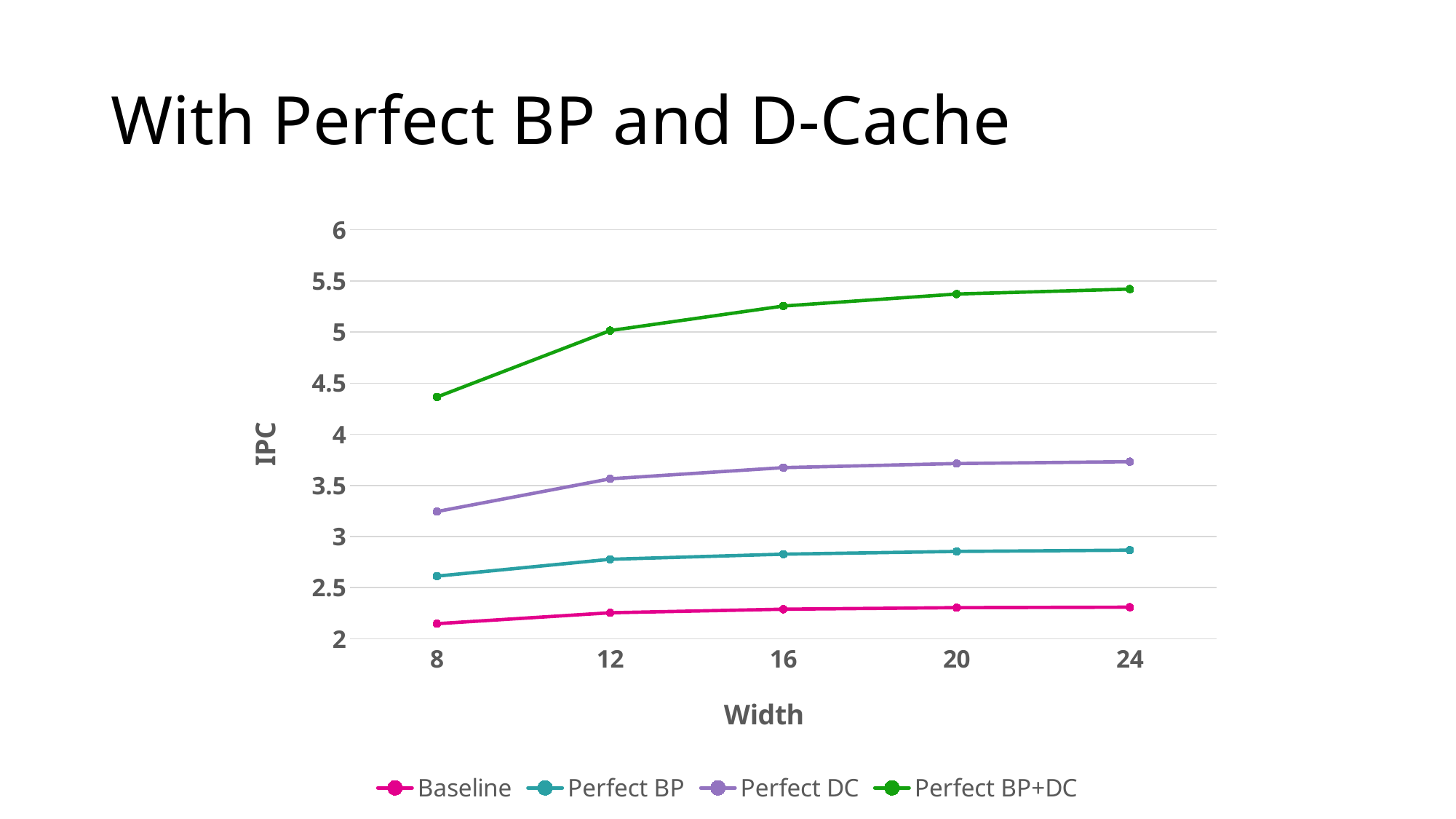
At width 16, which series has the larger IPC: Perfect DC or Perfect BP? Perfect DC Is the IPC for Perfect BP+DC at width 8 greater or less than 4.5? less Does the IPC for Perfect BP+DC rise or fall as width increases from 8 to 24? rise Is the IPC for Baseline at width 8 greater or less than 2.5? less Is the IPC for Perfect DC at width 24 greater or less than 3.5? greater Which series has the highest IPC at width 24? Perfect BP+DC Which series has the lowest IPC at width 8? Baseline How many width values are plotted along the x axis? 5 What is the label on the y axis of the chart? IPC What kind of chart is shown on the slide? line chart How many series does the legend list? 4